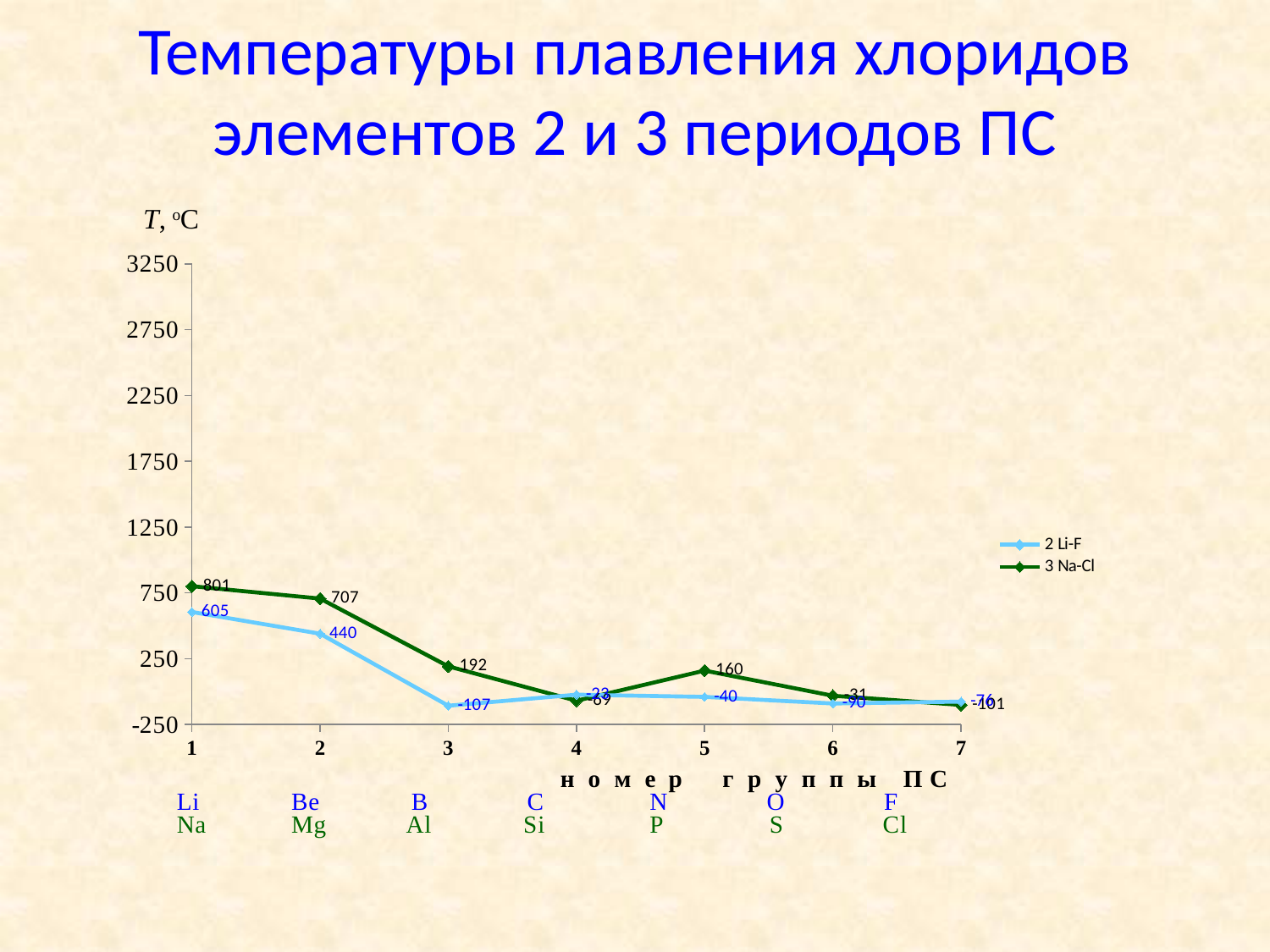
What is the value of the 3 Na-Cl series at group 1? 801 How many group numbers are plotted along the x axis? 7 How many series does the legend list? 2 At group 2, which series has the larger value, 2 Li-F or 3 Na-Cl? 3 Na-Cl What are the two series named in the legend? 2 Li-F and 3 Na-Cl What is the value of the 3 Na-Cl series at group 3? 192 What is the value of the 3 Na-Cl series at group 5? 160 What is the difference between the 3 Na-Cl and 2 Li-F values at group 1? 196 What kind of chart is shown on the slide? line chart What is the value of the 2 Li-F series at group 2? 440 At which group number does the 3 Na-Cl series reach its highest value? 1 At which group number does the 2 Li-F series reach its lowest value? 3